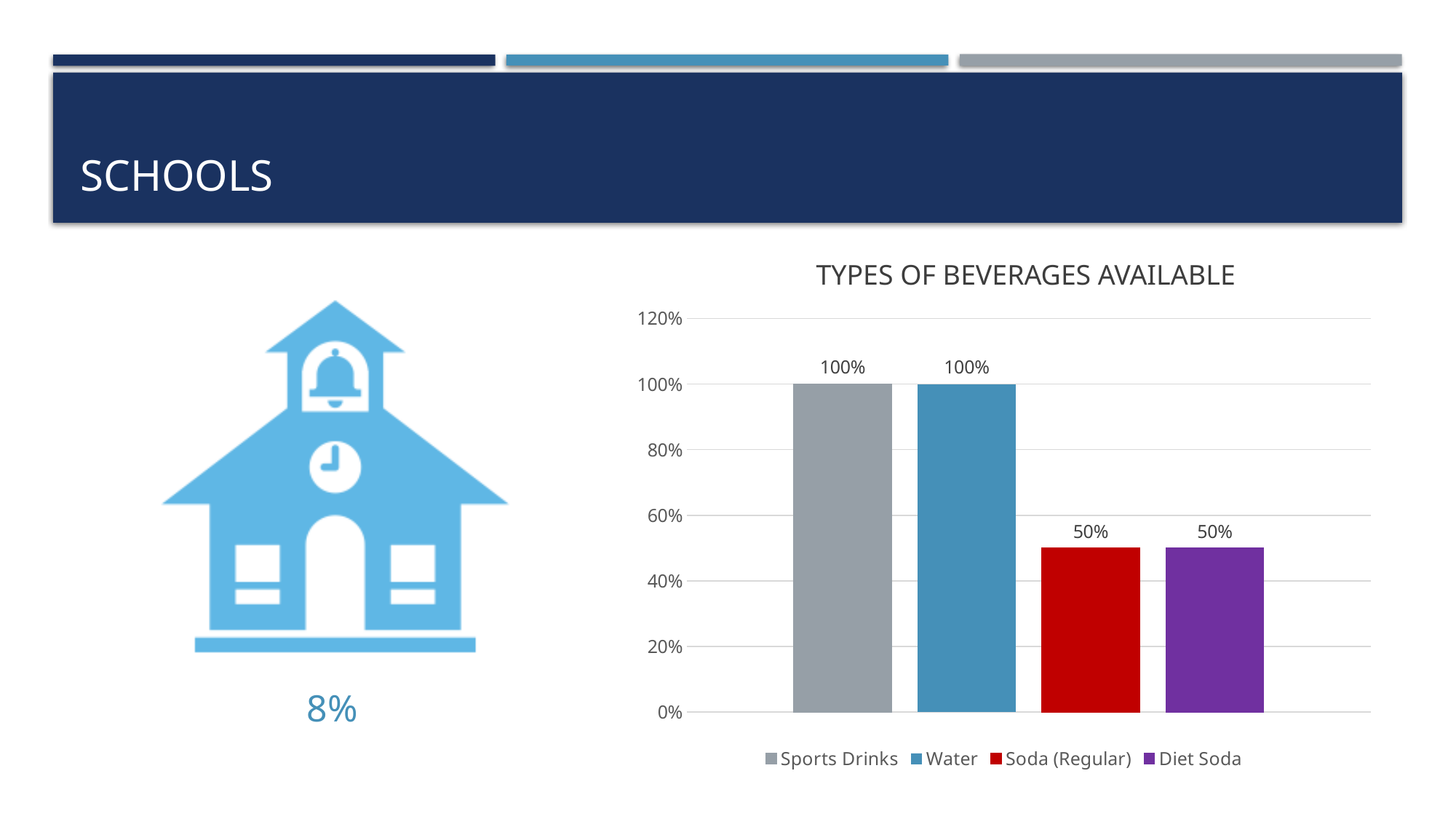
What is the value for Diet Soda in the Types of Beverages Available chart? 50% What is the difference between the values for Water and Diet Soda in the Types of Beverages Available chart? 50% Is the value for Diet Soda in the Types of Beverages Available chart greater or less than 80%? less What is the value for Soda (Regular) in the Types of Beverages Available chart? 50% What is the value for Sports Drinks in the Types of Beverages Available chart? 100% What is the title of the chart on the slide? Types of Beverages Available Which is larger in the Types of Beverages Available chart, Sports Drinks or Soda (Regular)? Sports Drinks What colour is the Soda (Regular) bar in the Types of Beverages Available chart? Red What is the value for Water in the Types of Beverages Available chart? 100% How many bars are shown in the Types of Beverages Available chart? 4 What kind of chart is the Types of Beverages Available chart? Bar chart How many entries does the legend of the Types of Beverages Available chart list? 4